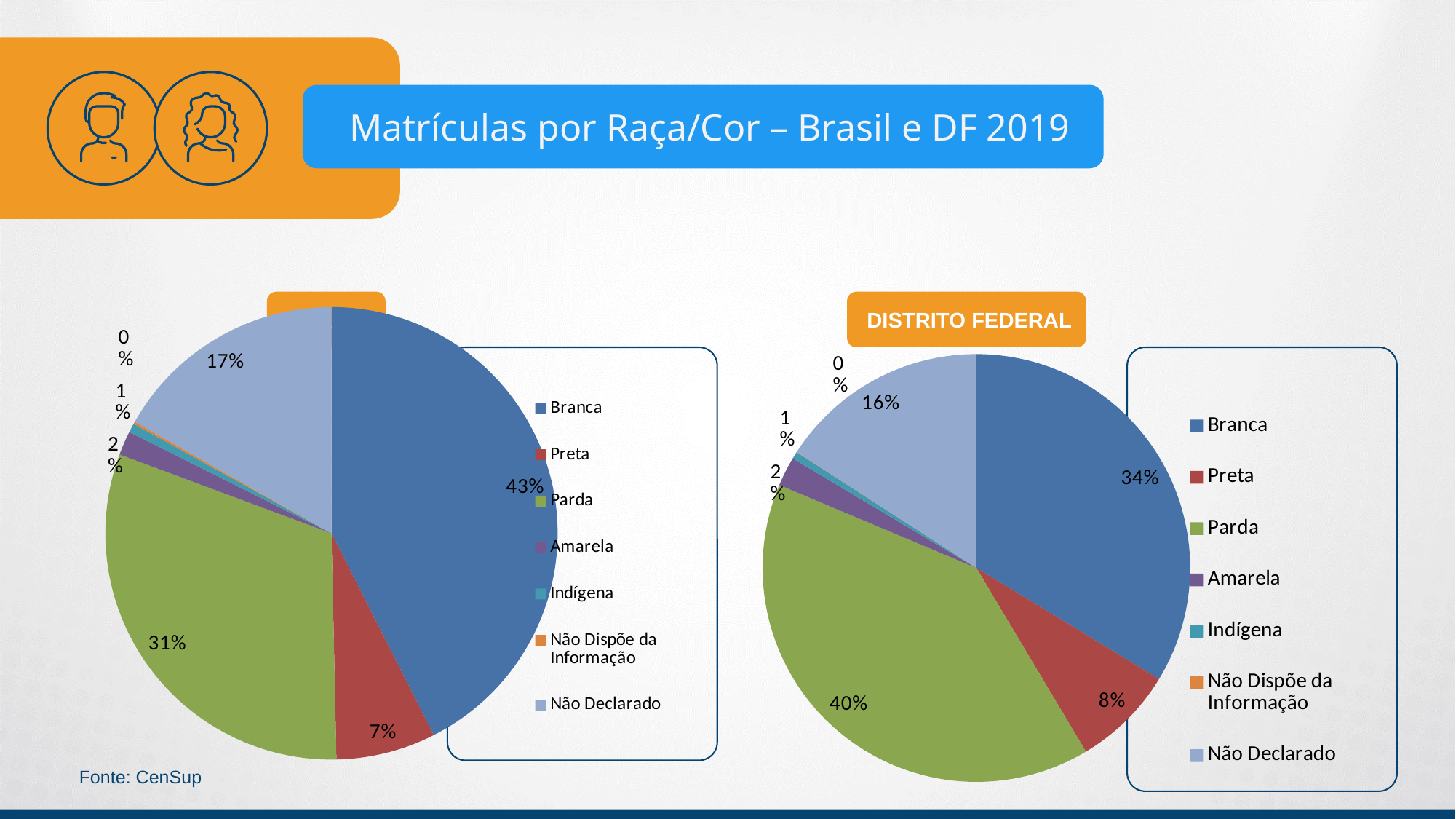
On the left pie chart, what share of enrolments is Não Declarado? 17% On the Distrito Federal pie chart, what is the difference between the Parda share and the Branca share? 6 percentage points What is the title of the slide? Matrículas por Raça/Cor – Brasil e DF 2019 On the Distrito Federal pie chart, what share of enrolments is Parda? 40% On the left pie chart, which category has the largest share? Branca On the Distrito Federal pie chart, what share of enrolments is Preta? 8% Which chart shows a larger share for Preta, the left pie chart or the Distrito Federal pie chart? Distrito Federal On the Distrito Federal pie chart, which category has the largest share? Parda On the left pie chart, what is the difference between the Branca share and the Parda share? 12 percentage points How many categories does the legend of the Distrito Federal pie chart list? 7 What type of chart is used on the slide? Pie chart On the left pie chart, what share of enrolments is Branca? 43%